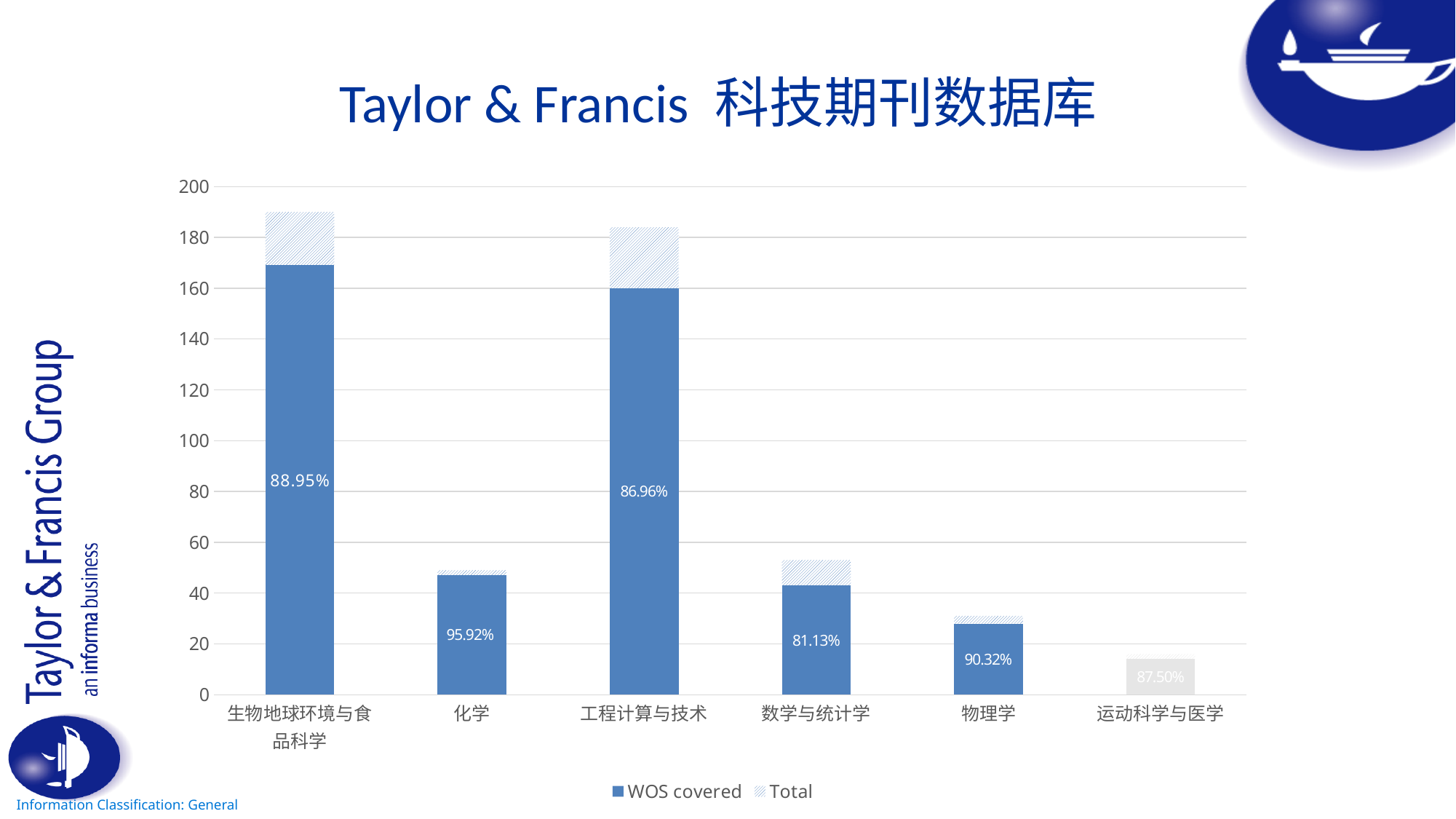
How many categories are shown on the x axis of the chart? 6 What percentage label is printed on the bar for 化学? 95.92% Which category has the tallest WOS covered bar? 生物地球环境与食品科学 What percentage label is printed on the bar for 数学与统计学? 81.13% What percentage label is printed on the bar for 物理学? 90.32% How many series does the chart's legend list? 2 What are the two series named in the chart's legend? WOS covered and Total Which category has the highest percentage label printed on its bar? 化学 Which category has the lowest percentage label printed on its bar? 数学与统计学 What percentage label is printed on the bar for 工程计算与技术? 86.96% What kind of chart is shown on the slide? bar chart Is the WOS covered value for 物理学 greater or less than 40? less